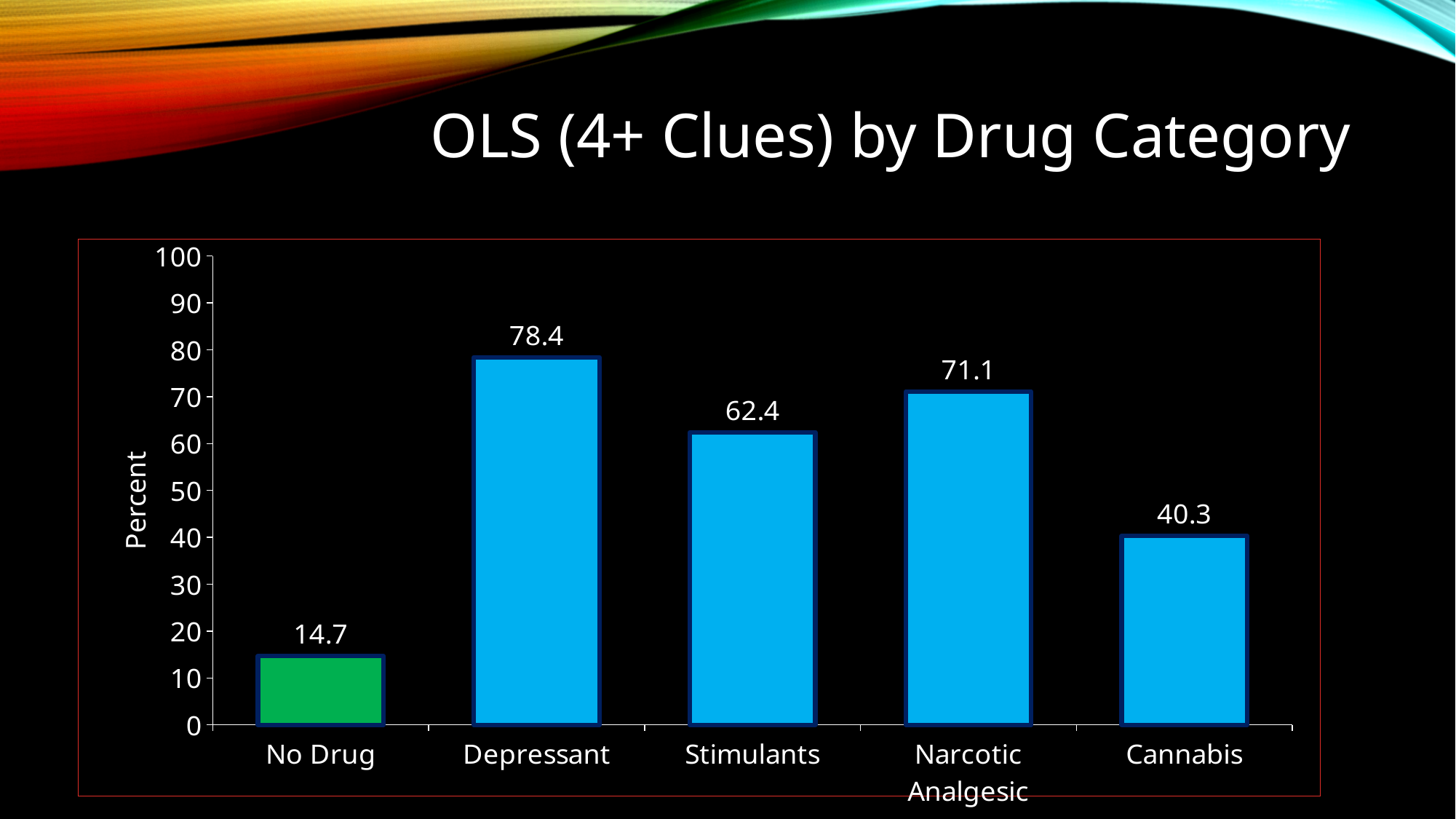
What is the value for Cannabis? 40.3 How many categories are shown on the x axis? 5 Which category has the highest value? Depressant What is the value for No Drug? 14.7 What is the difference between the values for Narcotic Analgesic and Cannabis? 30.8 What is the value for Depressant? 78.4 Which is larger, the value for Stimulants or the value for Narcotic Analgesic? Narcotic Analgesic What is the value for Narcotic Analgesic? 71.1 What is the label of the y axis? Percent What is the difference between the values for Depressant and Stimulants? 16.0 Which category has the lowest value? No Drug What kind of chart is shown on the slide? Bar chart